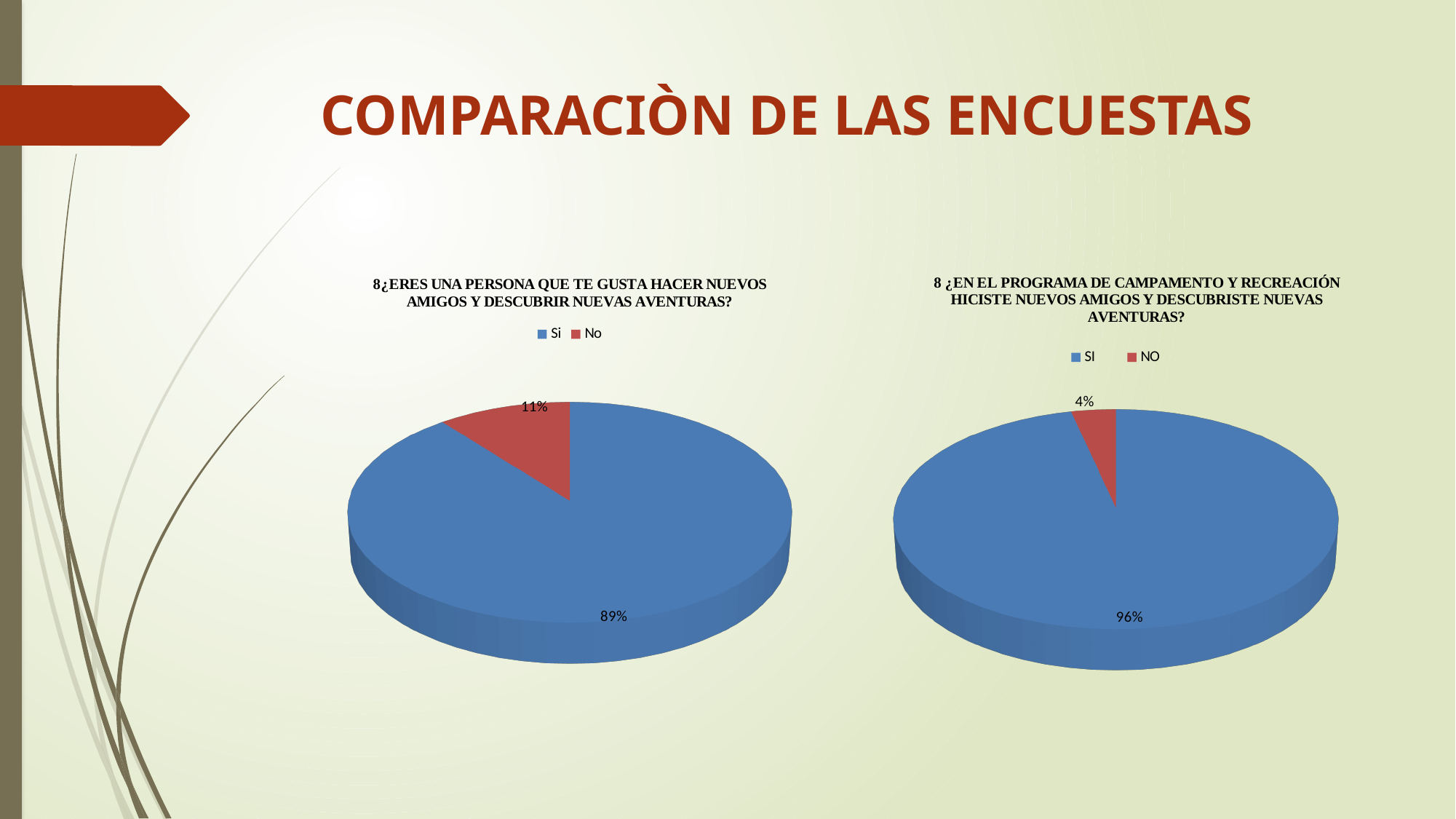
In the right pie chart, which category has the smallest slice? NO How many slices does the left pie chart have? 2 Which is larger: the No share in the left pie chart or the NO share in the right pie chart? No in the left pie chart In the left pie chart, which category has the largest slice? Si In the left pie chart, what share of respondents answered Si? 89% In the right pie chart, what share of respondents answered SI? 96% What type of chart is shown on the left of the slide? Pie chart In the left pie chart, what share of respondents answered No? 11% In the right pie chart, what colour is the SI slice? Blue How many categories does the legend of the right pie chart list? 2 What is the difference between the Si and No shares in the left pie chart? 78%